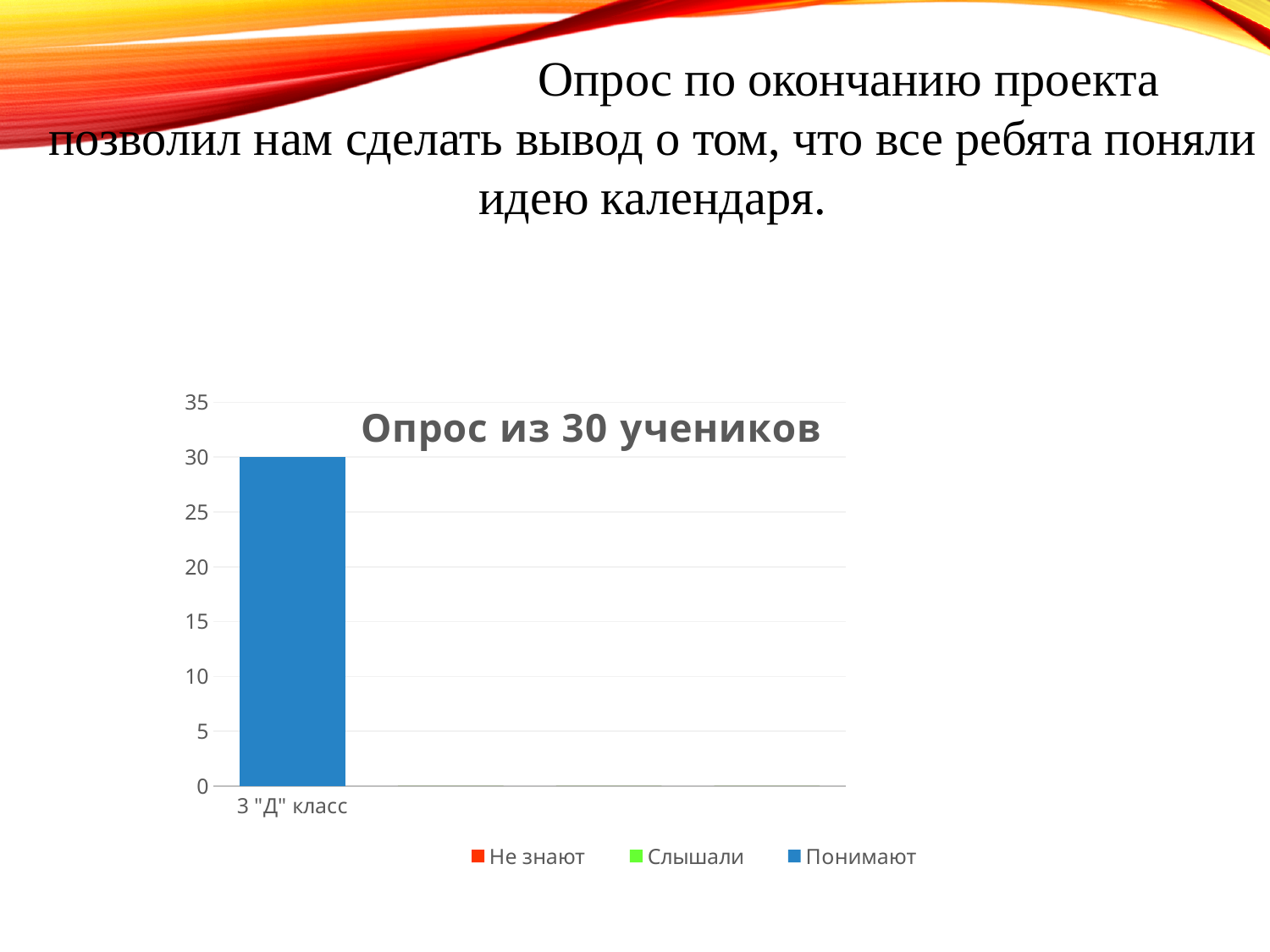
Which is larger for 3 "Д" класс: Понимают or Не знают? Понимают What type of chart is shown on the slide? bar chart What is the label of the category on the x axis? 3 "Д" класс How many categories are shown on the x axis? 1 Which series has the highest value for 3 "Д" класс? Понимают Is the value for Понимают greater or less than 25? greater What colour represents the Понимают series in the legend? blue Is the value for Слышали greater or less than 5? less What is the title of the chart? Опрос из 30 учеников What is the value for Понимают for 3 "Д" класс? 30 Is the value for Не знают greater or less than 5? less How many series does the legend list? 3